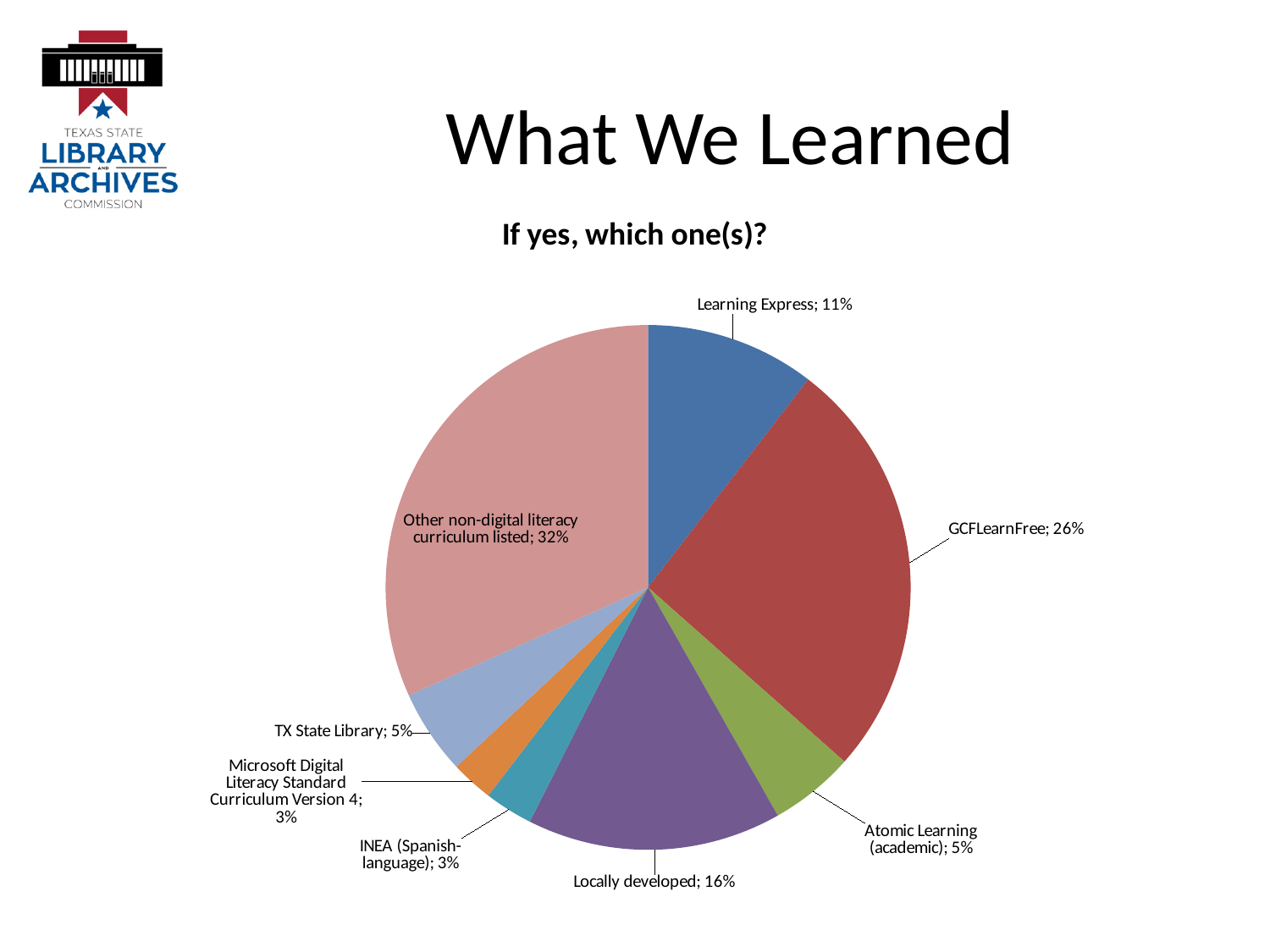
Which category has the largest slice of the pie? Other non-digital literacy curriculum listed What type of chart is shown on the slide? Pie chart What percentage of the pie is GCFLearnFree? 26% What is the difference in percentage points between Other non-digital literacy curriculum listed and GCFLearnFree? 6 What is the value for TX State Library? 5% What percentage is shown for Locally developed? 16% What is the title of the chart? If yes, which one(s)? What is the difference in percentage points between Learning Express and Atomic Learning (academic)? 6 What percentage is shown for INEA (Spanish-language)? 3% Which is larger, GCFLearnFree or Locally developed? GCFLearnFree What share of the pie does Learning Express have? 11% How many slices does the pie chart have? 8